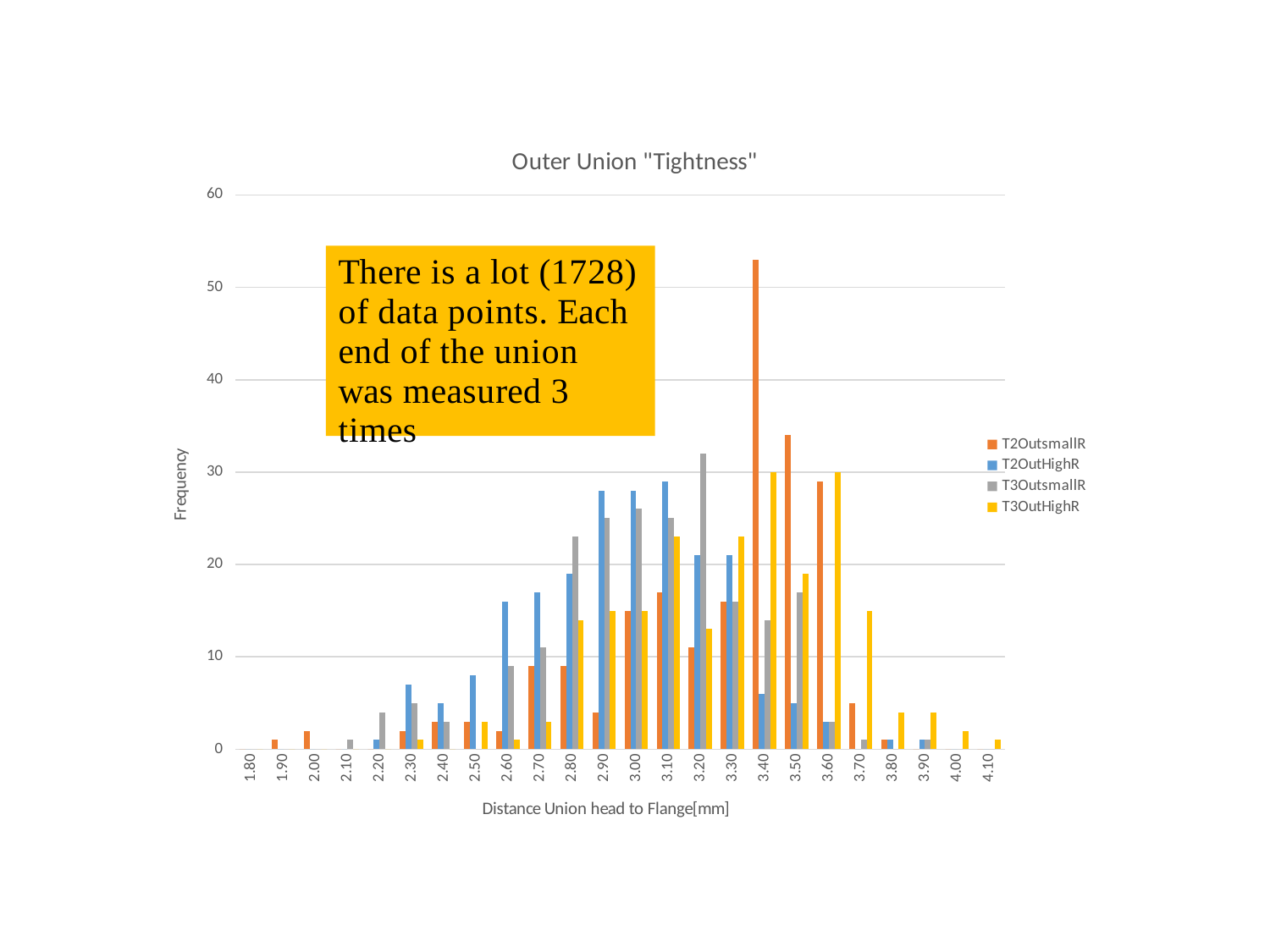
Is the T2OutHighR value at 2.90 greater or less than 20? greater Is the T3OutHighR value at 3.70 greater or less than 20? less At which x-axis value does T2OutsmallR reach its highest frequency? 3.40 Which series has the tallest bar in the chart? T2OutsmallR Is the T2OutsmallR value at 3.50 greater or less than 30? greater What is the title of the chart? Outer Union "Tightness" What kind of chart is shown on the slide? bar chart How many series does the legend list? 4 At 2.90, which is larger: T2OutHighR or T2OutsmallR? T2OutHighR How many categories are shown along the x axis? 24 At 3.20, which is larger: T3OutsmallR or T2OutHighR? T3OutsmallR